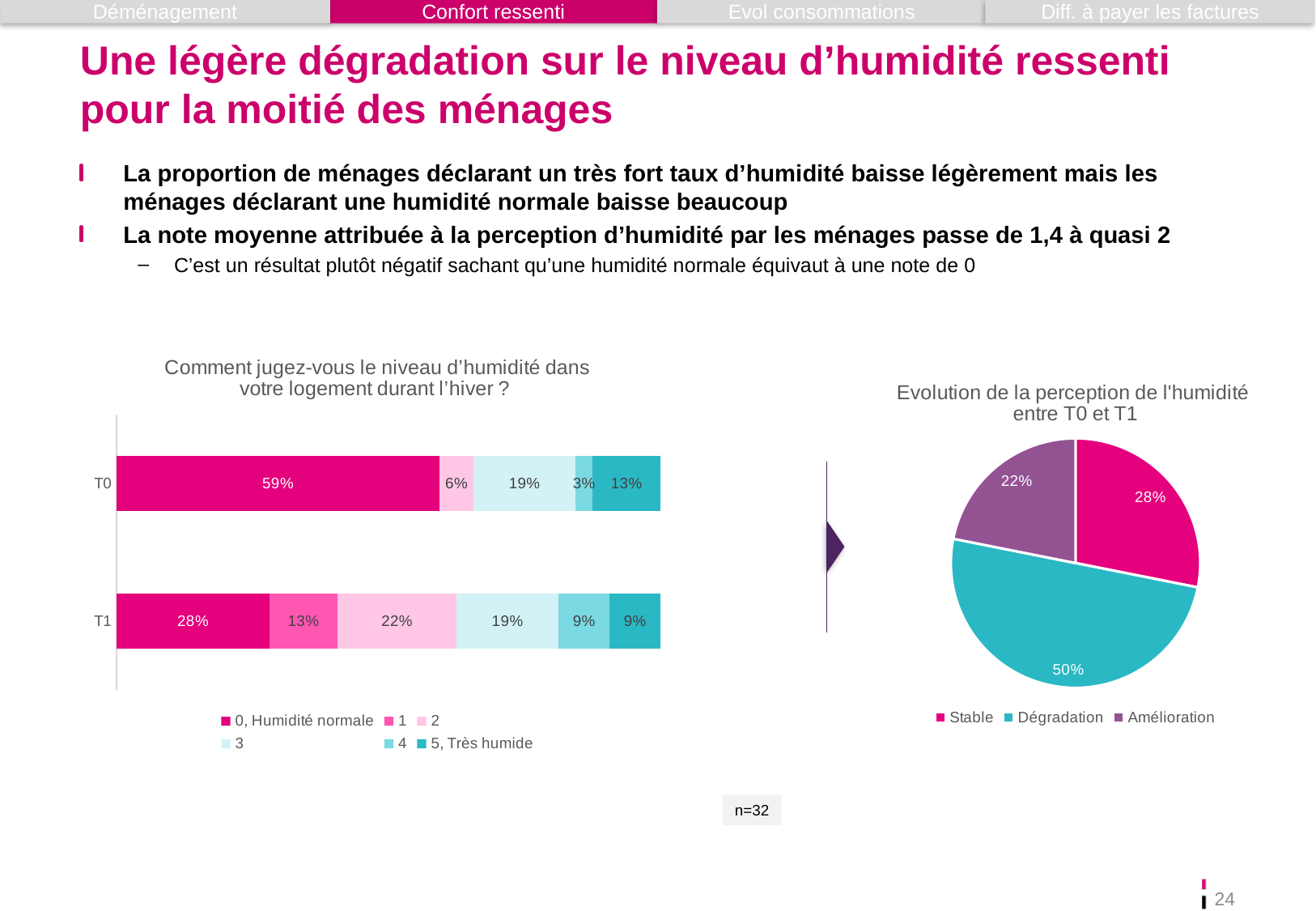
In the chart 'Comment jugez-vous le niveau d'humidité dans votre logement durant l'hiver ?', how many bars are shown? 2 In the chart 'Comment jugez-vous le niveau d'humidité dans votre logement durant l'hiver ?', what is the value for '0, Humidité normale' at T1? 28% In the chart 'Comment jugez-vous le niveau d'humidité dans votre logement durant l'hiver ?', what is the difference between the '0, Humidité normale' values at T0 and T1? 31% In the chart 'Evolution de la perception de l'humidité entre T0 et T1', what is the share for 'Dégradation'? 50% In the chart 'Evolution de la perception de l'humidité entre T0 et T1', which category has the smallest slice? Amélioration In the chart 'Evolution de la perception de l'humidité entre T0 et T1', what is the difference between 'Stable' and 'Amélioration'? 6% In the chart 'Comment jugez-vous le niveau d'humidité dans votre logement durant l'hiver ?', how many series does the legend list? 6 What kind of chart is 'Evolution de la perception de l'humidité entre T0 et T1'? Pie chart In the chart 'Comment jugez-vous le niveau d'humidité dans votre logement durant l'hiver ?', what is the value for '0, Humidité normale' at T0? 59% What kind of chart is 'Comment jugez-vous le niveau d'humidité dans votre logement durant l'hiver ?'? Stacked bar chart In the chart 'Comment jugez-vous le niveau d'humidité dans votre logement durant l'hiver ?', which is larger: the '5, Très humide' value at T0 or at T1? T0 In the chart 'Comment jugez-vous le niveau d'humidité dans votre logement durant l'hiver ?', what is the value for '5, Très humide' at T1? 9%